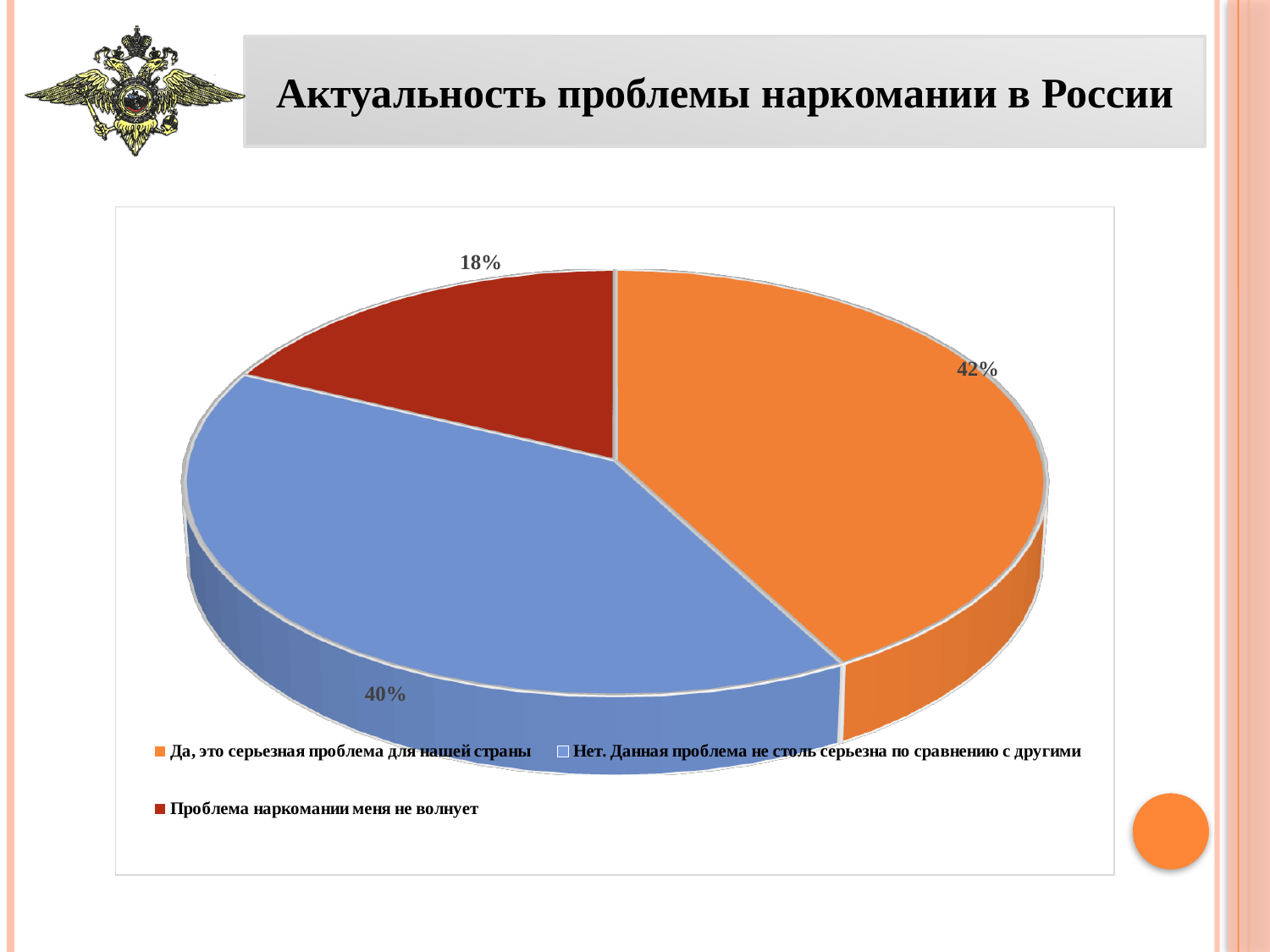
What is the difference in percentage points between the "Да, это серьезная проблема для нашей страны" slice and the "Нет. Данная проблема не столь серьезна по сравнению с другими" slice? 2 What kind of chart is shown on the slide? pie chart What share of respondents answered "Да, это серьезная проблема для нашей страны"? 42% What is the difference in percentage points between the "Да, это серьезная проблема для нашей страны" slice and the "Проблема наркомании меня не волнует" slice? 24 What colour is the slice for "Проблема наркомании меня не волнует"? dark red Which slice is larger: "Нет. Данная проблема не столь серьезна по сравнению с другими" or "Проблема наркомании меня не волнует"? Нет. Данная проблема не столь серьезна по сравнению с другими What is the title of the slide containing the pie chart? Актуальность проблемы наркомании в России What share of respondents answered "Проблема наркомании меня не волнует"? 18% What share of respondents answered "Нет. Данная проблема не столь серьезна по сравнению с другими"? 40% Which answer option has the smallest share of the pie? Проблема наркомании меня не волнует How many slices does the pie chart have? 3 Which answer option has the largest share of the pie? Да, это серьезная проблема для нашей страны